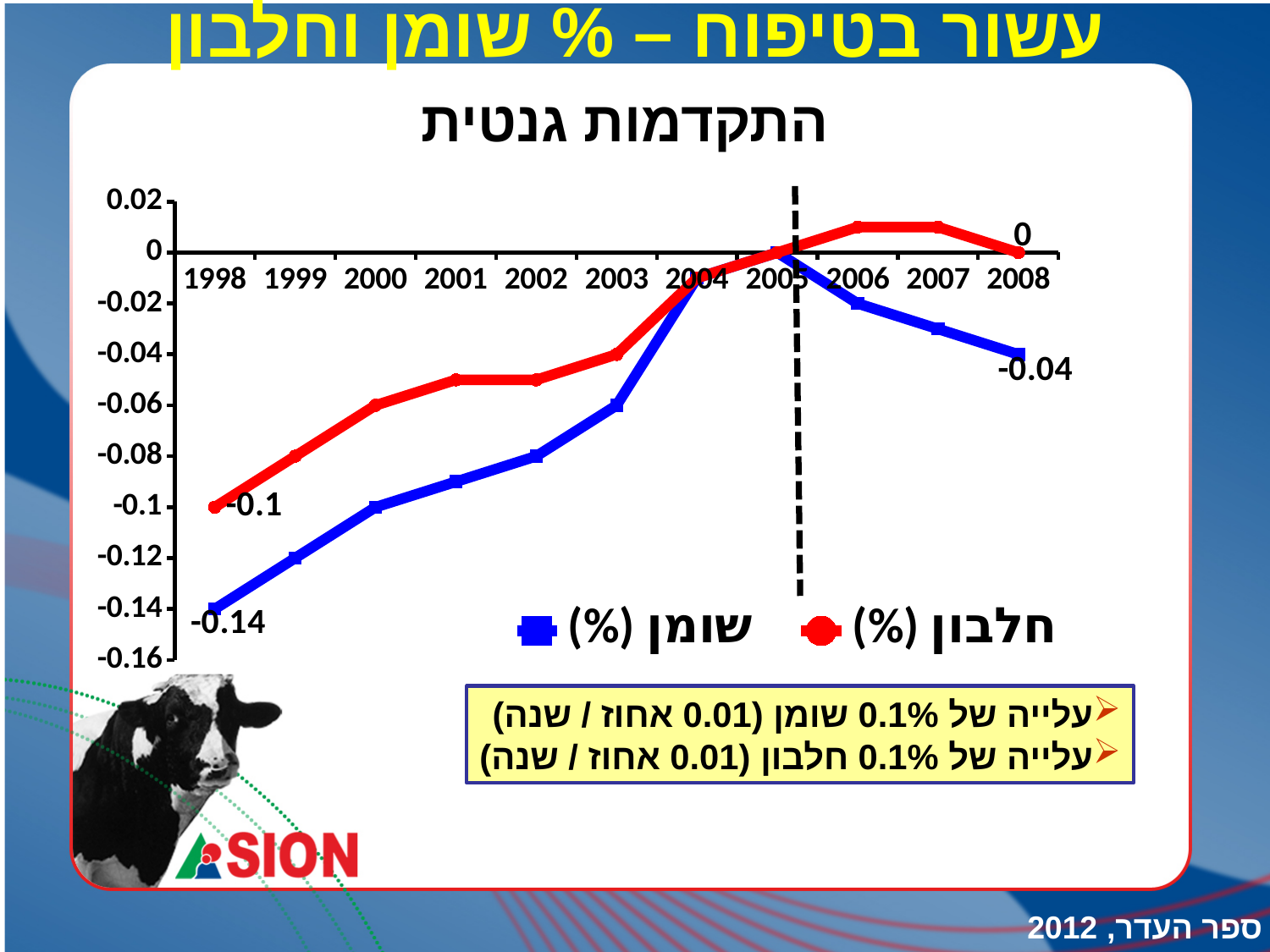
What is the value of the חלבון (%) series in 2008? 0 What is the title of the chart? התקדמות גנטית Is the value of the שומן (%) series in 2000 greater or less than -0.08? less How many years are shown on the x axis? 11 What is the value of the חלבון (%) series in 1998? -0.1 By how much did the חלבון (%) series change from 1998 to 2008? 0.1 What is the value of the שומן (%) series in 1998? -0.14 In 1998, which series has the higher value, שומן (%) or חלבון (%)? חלבון (%) What kind of chart is shown on the slide? line chart What is the value of the שומן (%) series in 2008? -0.04 By how much did the שומן (%) series change from 1998 to 2008? 0.1 How many series does the legend list? 2